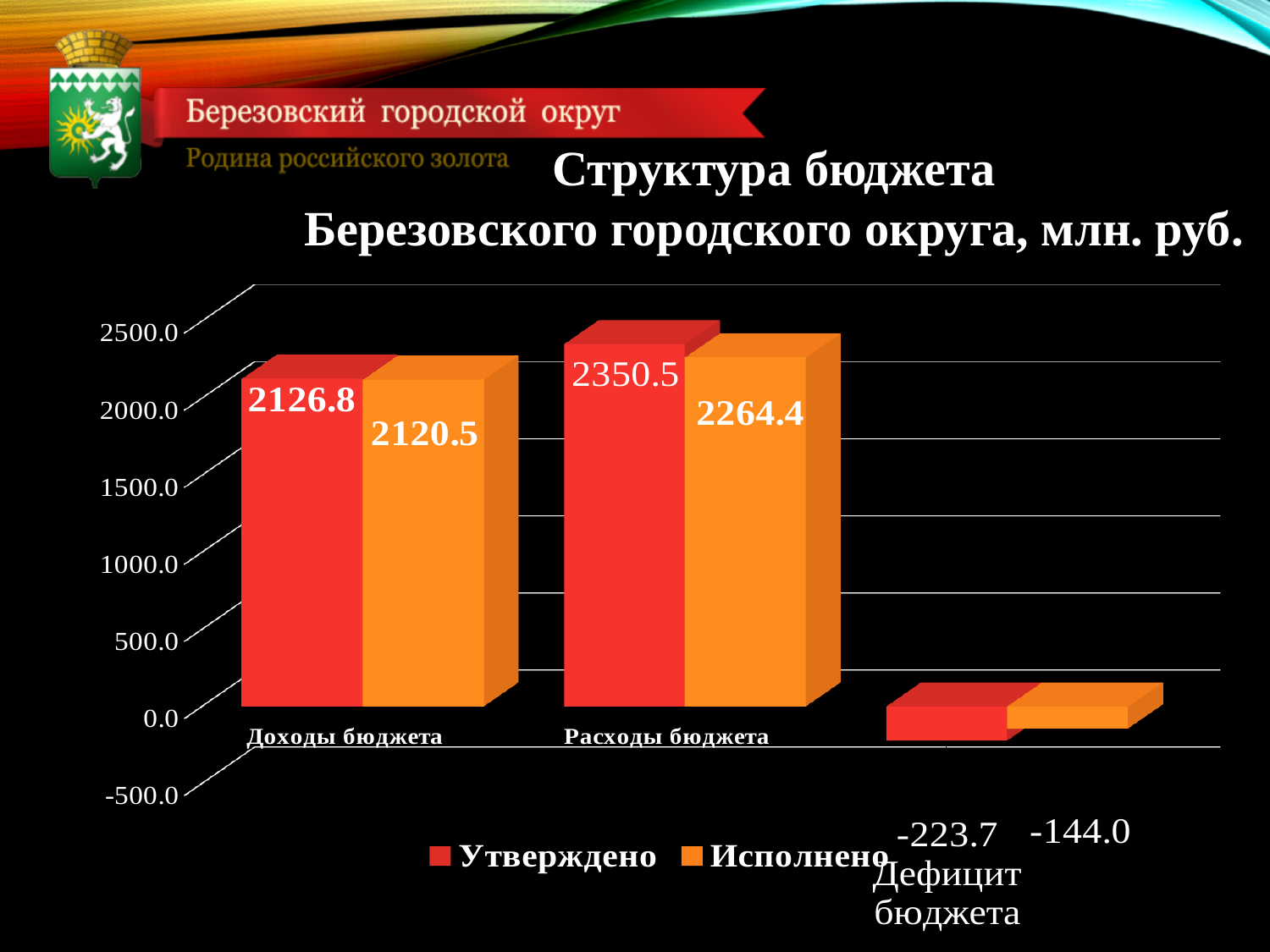
Is the Утверждено value for Расходы бюджета greater or less than 2000.0? greater What is the Исполнено value for Доходы бюджета? 2120.5 Which is larger for Доходы бюджета: the Утверждено value or the Исполнено value? Утверждено What is the Утверждено value for Дефицит бюджета? -223.7 How many series does the legend list? 2 How many categories are shown on the x axis? 3 What is the Утверждено value for Доходы бюджета? 2126.8 What kind of chart is shown on the slide? bar chart What is the difference between the Утверждено and Исполнено values for Расходы бюджета? 86.1 Which category has the highest Утверждено value? Расходы бюджета What is the Исполнено value for Расходы бюджета? 2264.4 Which category has the lowest Исполнено value? Дефицит бюджета